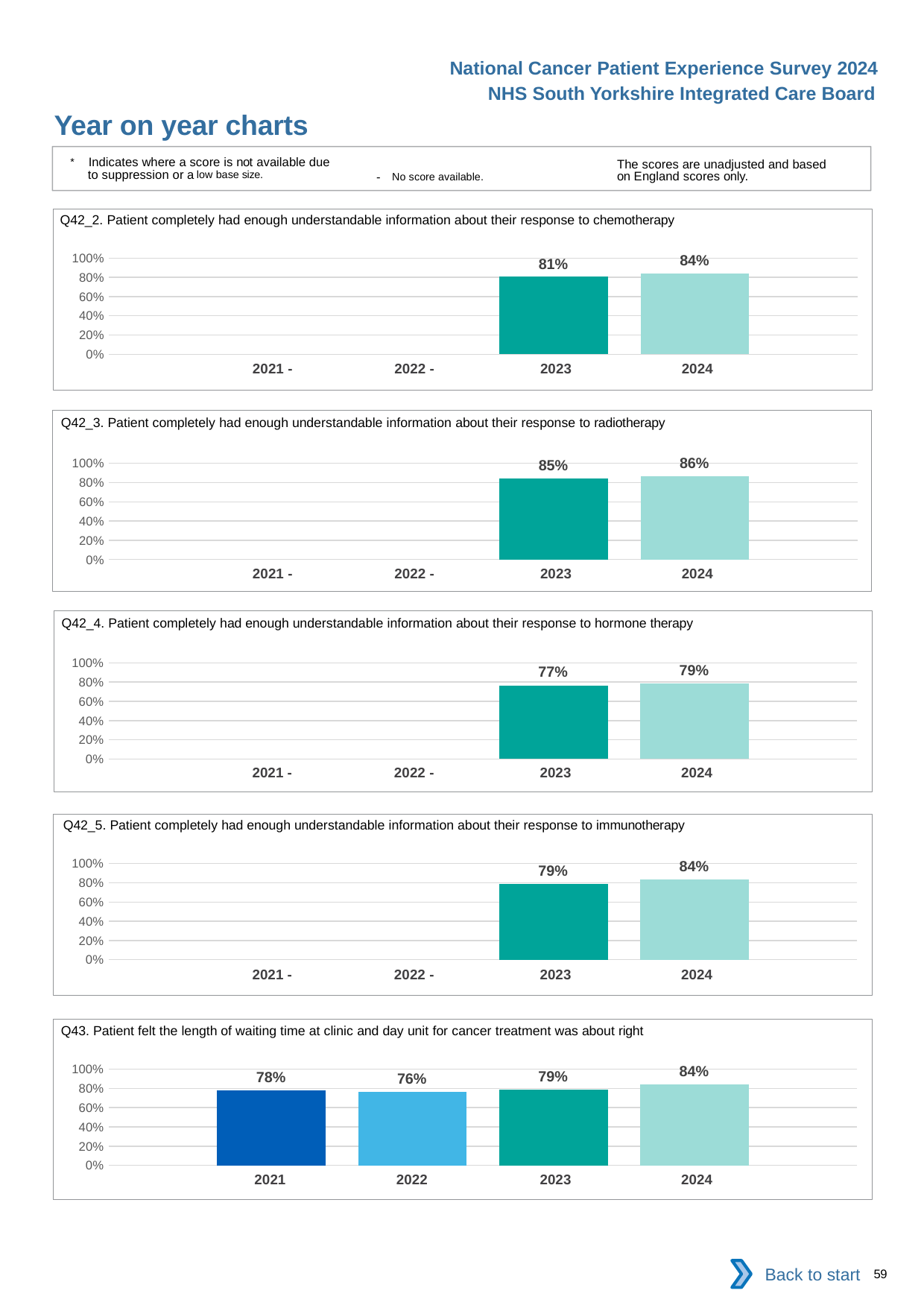
In the Q42_3 chart (radiotherapy), what is the value for 2024? 86% In the Q42_2 chart (chemotherapy), how many years have a bar plotted? 2 In the Q42_4 chart (hormone therapy), is the value for 2024 greater or less than 80%? less In the Q42_2 chart (chemotherapy), what is the value for 2023? 81% In the Q42_5 chart (immunotherapy), what is the difference between the 2024 and 2023 values? 5% In the Q43 chart (waiting time at clinic and day unit), how many years have a bar plotted? 4 In the Q43 chart (waiting time at clinic and day unit), which year has the lowest value? 2022 In the Q43 chart (waiting time at clinic and day unit), which year has the highest value? 2024 In the Q43 chart (waiting time at clinic and day unit), what is the value for 2021? 78% In the Q42_3 chart (radiotherapy), which year has the larger value, 2023 or 2024? 2024 In the Q42_4 chart (hormone therapy), what is the value for 2023? 77% What kind of chart is the Q43 chart (waiting time at clinic and day unit)? bar chart